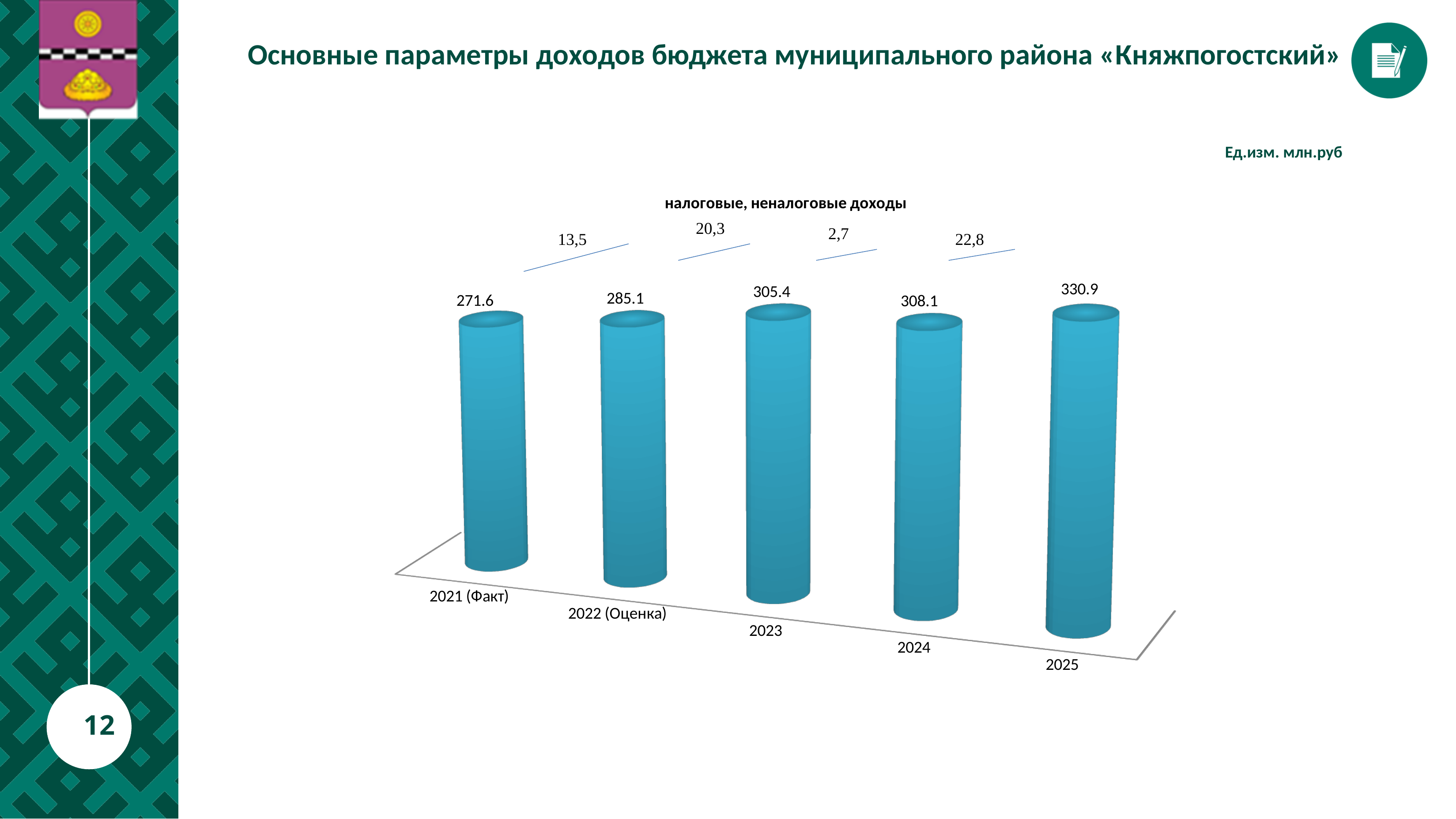
What is the difference between the values for 2025 and 2024? 22.8 What is the value for 2021 (Факт)? 271.6 How many categories are shown on the chart? 5 Do the values rise or fall from 2021 (Факт) to 2025? Rise What is the difference between the values for 2023 and 2022 (Оценка)? 20.3 What is the value for 2023? 305.4 What is the value for 2025? 330.9 Which category has the lowest value? 2021 (Факт) What is the value for 2022 (Оценка)? 285.1 Which year has the highest value? 2025 Which is larger, the value for 2023 or the value for 2022 (Оценка)? 2023 What kind of chart is shown on the slide? Bar chart